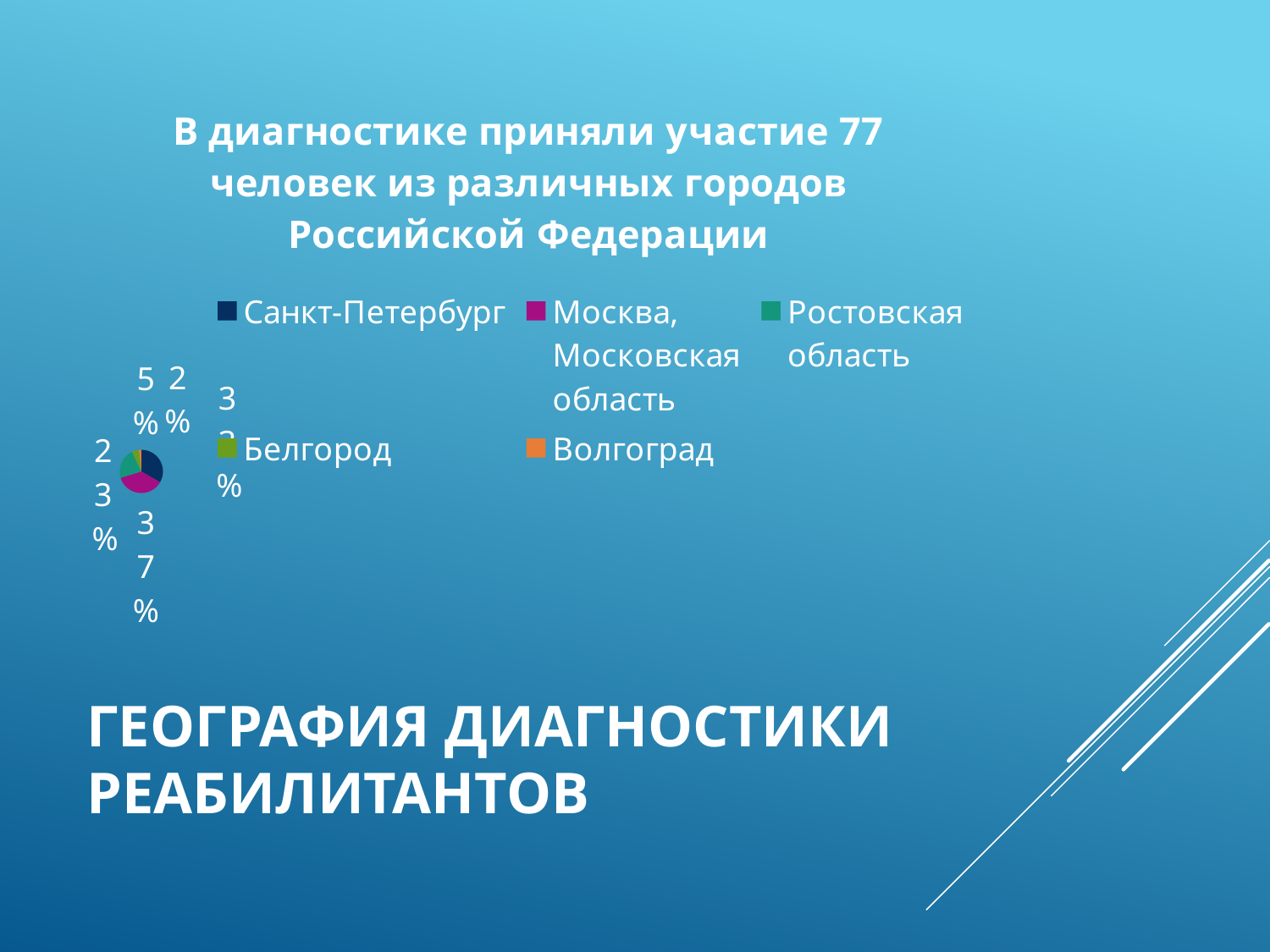
How many slices does the pie chart have? 5 Which slice is larger in the pie chart: Санкт-Петербург or Волгоград? Санкт-Петербург How many entries does the legend of the pie chart list? 5 What kind of chart is shown on the slide? pie chart Which slice is larger in the pie chart: Москва, Московская область or Белгород? Москва, Московская область According to the chart title, how many people took part in the diagnostics? 77 What is the title of the pie chart? В диагностике приняли участие 77 человек из различных городов Российской Федерации